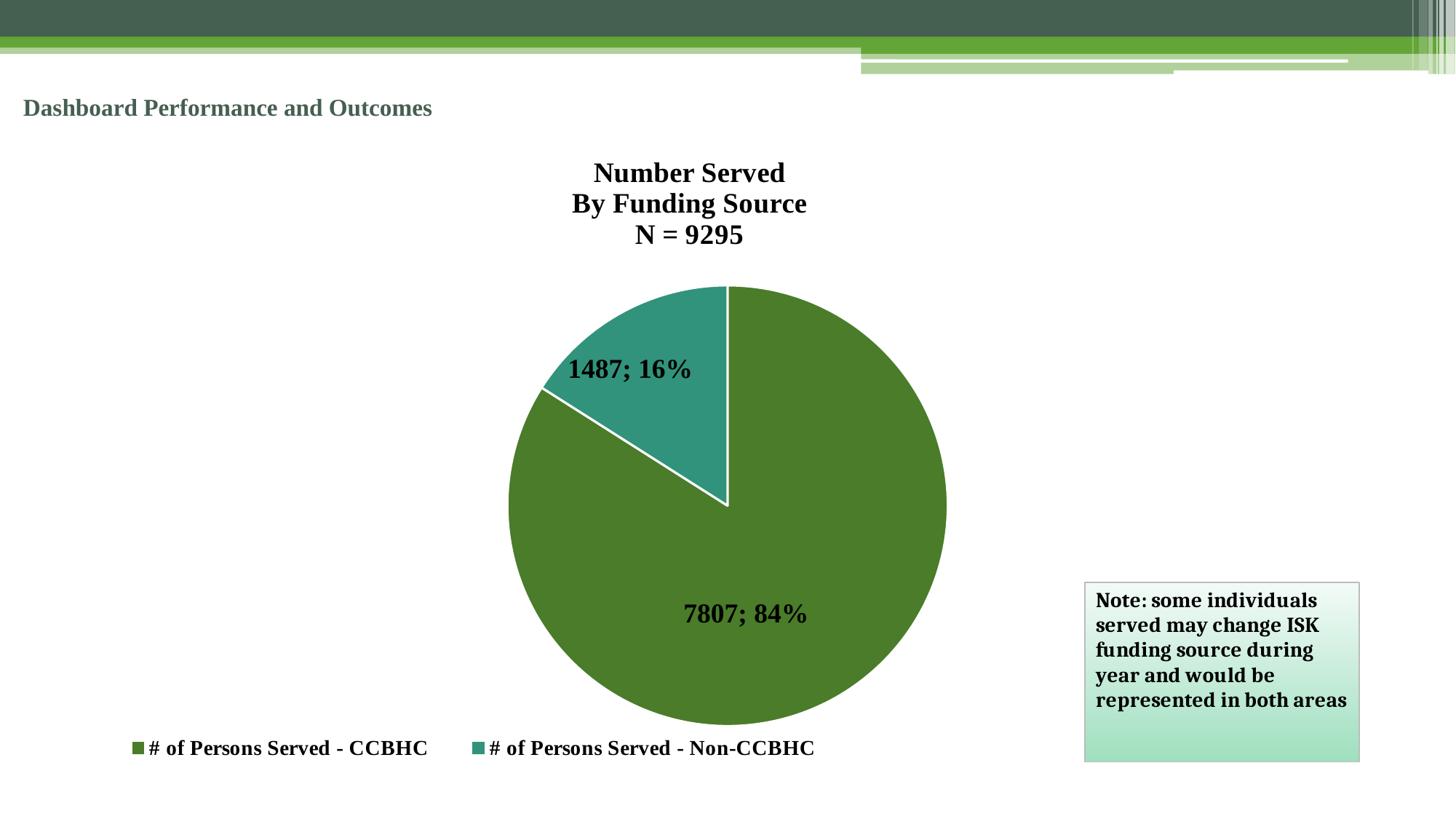
What is the difference between the number of persons served for CCBHC and Non-CCBHC? 6320 Which is larger, the number of persons served for CCBHC or for Non-CCBHC? CCBHC How many slices does the pie chart have? 2 What is the total number served (N) stated in the chart title? 9295 How many persons served are shown for CCBHC? 7807 What share of the pie does the CCBHC slice represent? 84% What is the title of the chart? Number Served By Funding Source N = 9295 How many persons served are shown for Non-CCBHC? 1487 What share of the pie does the Non-CCBHC slice represent? 16% Which funding source has the largest number of persons served? # of Persons Served - CCBHC What type of chart is shown on the slide? pie chart Which funding source has the smallest number of persons served? # of Persons Served - Non-CCBHC